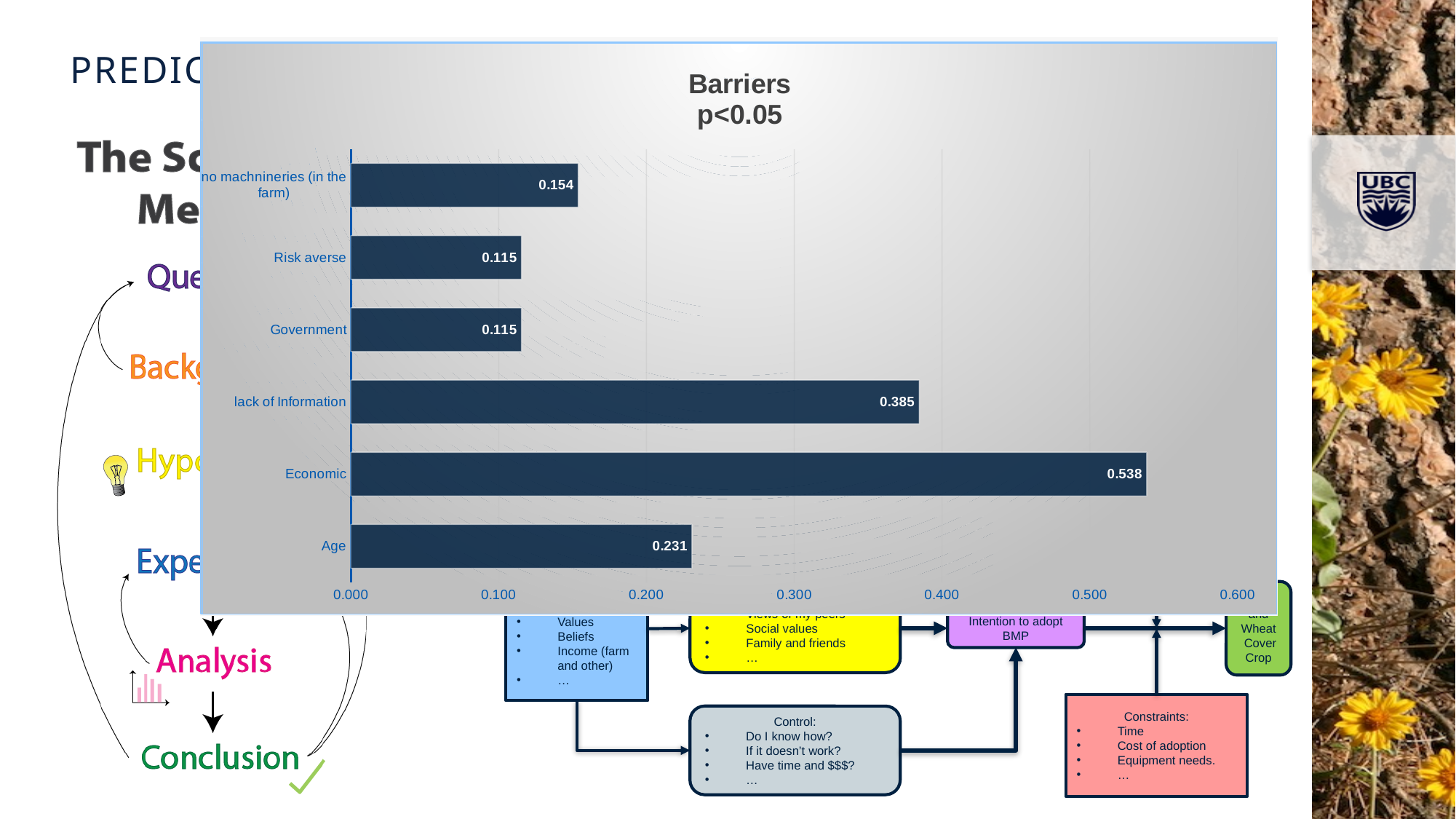
What is the value for lack of Information in the Barriers chart? 0.385 How many categories are shown in the Barriers chart? 6 Is the value for Economic greater or less than 0.500? greater What is the value for Age in the Barriers chart? 0.231 Which is larger, the value for Age or the value for Government? Age Which category has the highest value in the Barriers chart? Economic What is the difference between the values for Age and Risk averse? 0.116 What is the title of the chart? Barriers p<0.05 What kind of chart is the Barriers chart? bar chart What is the value for Risk averse in the Barriers chart? 0.115 What is the value for Economic in the Barriers chart? 0.538 What is the difference between the values for Economic and lack of Information? 0.153